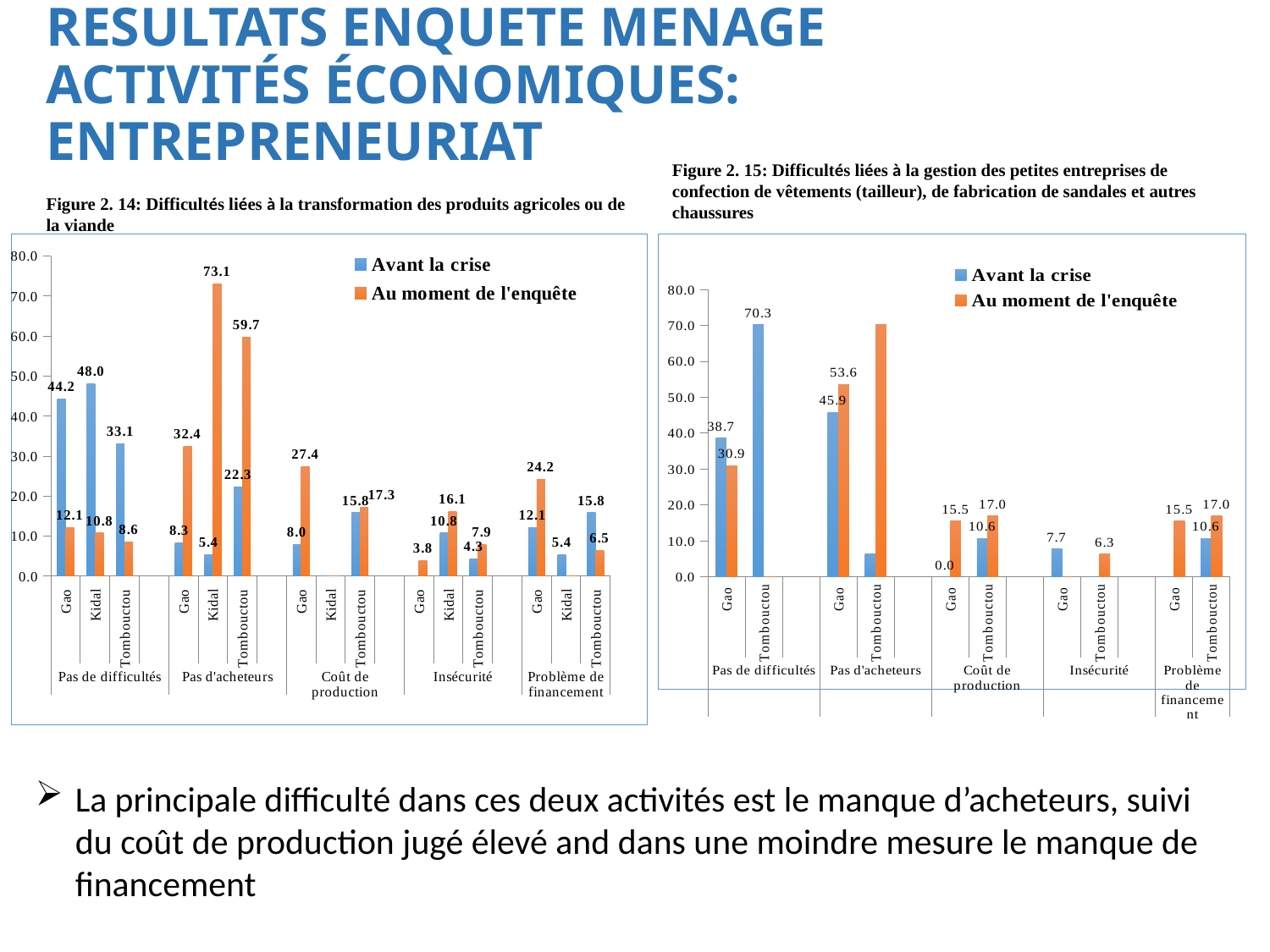
In Figure 2.15 (right chart), what is the value for Tombouctou under 'Pas de difficultés' for the series 'Avant la crise'? 70.3 In Figure 2.14 (left chart), which bar has the highest value overall? Kidal, Pas d'acheteurs, Au moment de l'enquête (73.1) In Figure 2.14 (left chart), what is the value for Kidal under 'Pas d'acheteurs' for the series 'Au moment de l'enquête'? 73.1 In Figure 2.15 (right chart), what is the value for Gao under 'Pas d'acheteurs' for the series 'Au moment de l'enquête'? 53.6 In Figure 2.15 (right chart), what is the 'Avant la crise' value for Gao under 'Coût de production'? 0.0 In Figure 2.14 (left chart), what is the value for Gao under 'Pas de difficultés' for the series 'Avant la crise'? 44.2 How many series does the legend of Figure 2.14 (left chart) list? 2 In Figure 2.15 (right chart), which colour represents the series 'Au moment de l'enquête'? Orange In Figure 2.14 (left chart), what is the difference between the 'Au moment de l'enquête' and 'Avant la crise' values for Tombouctou under 'Pas d'acheteurs'? 37.4 In Figure 2.14 (left chart), under 'Problème de financement', which is larger for Gao: 'Avant la crise' or 'Au moment de l'enquête'? Au moment de l'enquête What type of chart is Figure 2.15 (right chart)? Bar chart In Figure 2.15 (right chart), what is the difference between 'Au moment de l'enquête' and 'Avant la crise' for Gao under 'Pas d'acheteurs'? 7.7